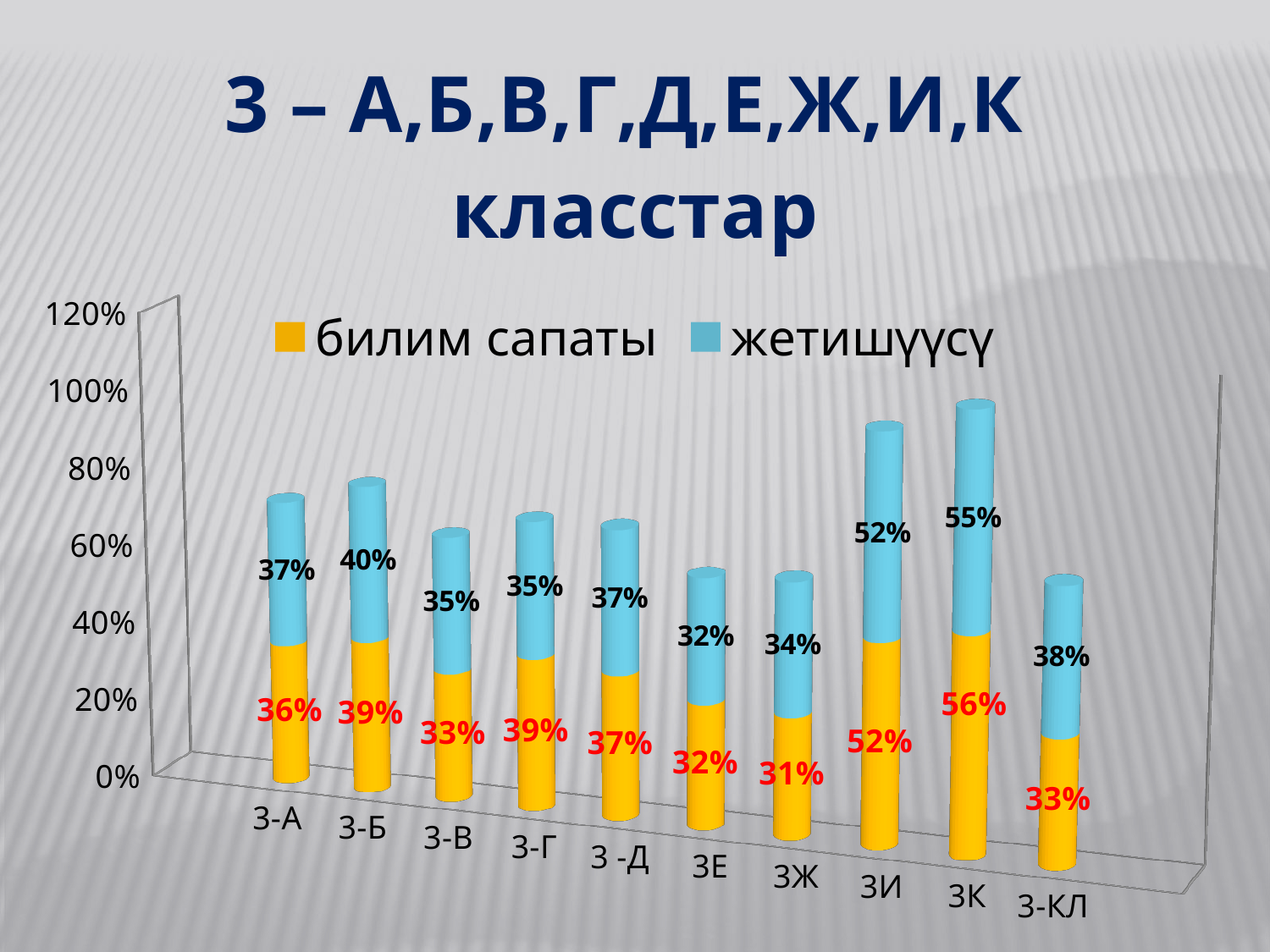
How many classes (categories) are shown on the x axis? 10 Which class has the highest билим сапаты value? 3К How many series does the legend list? 2 What is the difference between the билим сапаты values of 3К and 3И? 4% What is the value of билим сапаты for 3Ж? 31% Which is larger: the жетишүүсү value for 3-Б or for 3-В? 3-Б What is the value of жетишүүсү for 3-КЛ? 38% Which class has the highest жетишүүсү value? 3К What is the value of билим сапаты for 3-Б? 39% What type of chart is shown on the slide? stacked bar chart What is the total height of the stacked bar for 3К (билим сапаты plus жетишүүсү)? 111% Which class has the lowest билим сапаты value? 3Ж